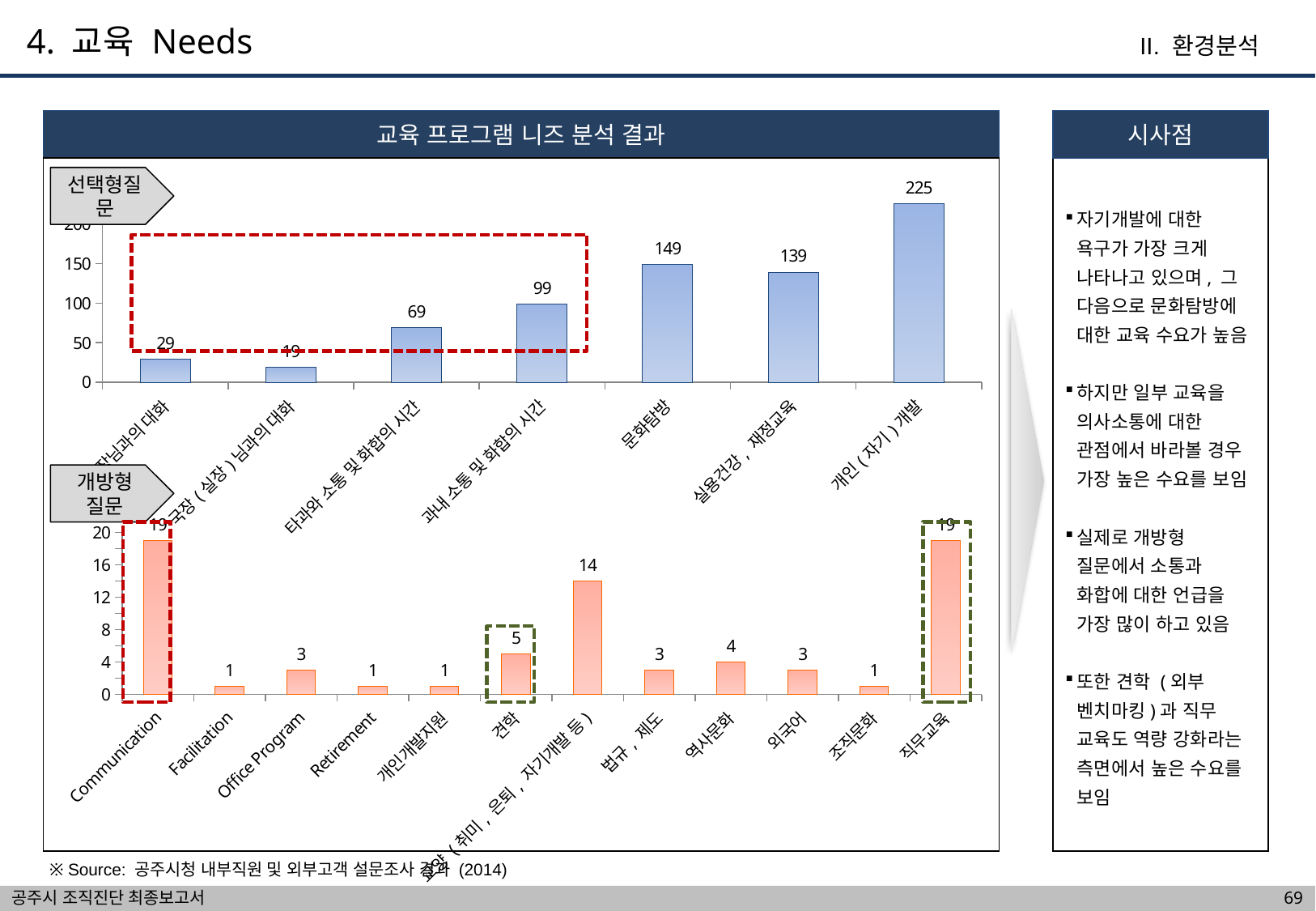
In the bottom chart (개방형 질문), what is the difference between Communication and 견학? 14 In the top chart (선택형질문), which category has the highest value? 개인(자기)개발 In the bottom chart (개방형 질문), what is the value for 역사문화? 4 In the top chart (선택형질문), which is larger: 과내 소통 및 화합의 시간 or 타과와 소통 및 화합의 시간? 과내 소통 및 화합의 시간 In the top chart (선택형질문), what is the value for 개인(자기)개발? 225 In the top chart (선택형질문), how many bars are plotted? 7 In the top chart (선택형질문), what is the difference between 문화탐방 and 실용건강, 재정교육? 10 In the bottom chart (개방형 질문), how many categories are plotted? 12 In the bottom chart (개방형 질문), what is the value for 견학? 5 In the top chart (선택형질문), what is the value for 문화탐방? 149 What type of chart is the bottom chart (개방형 질문)? Bar chart